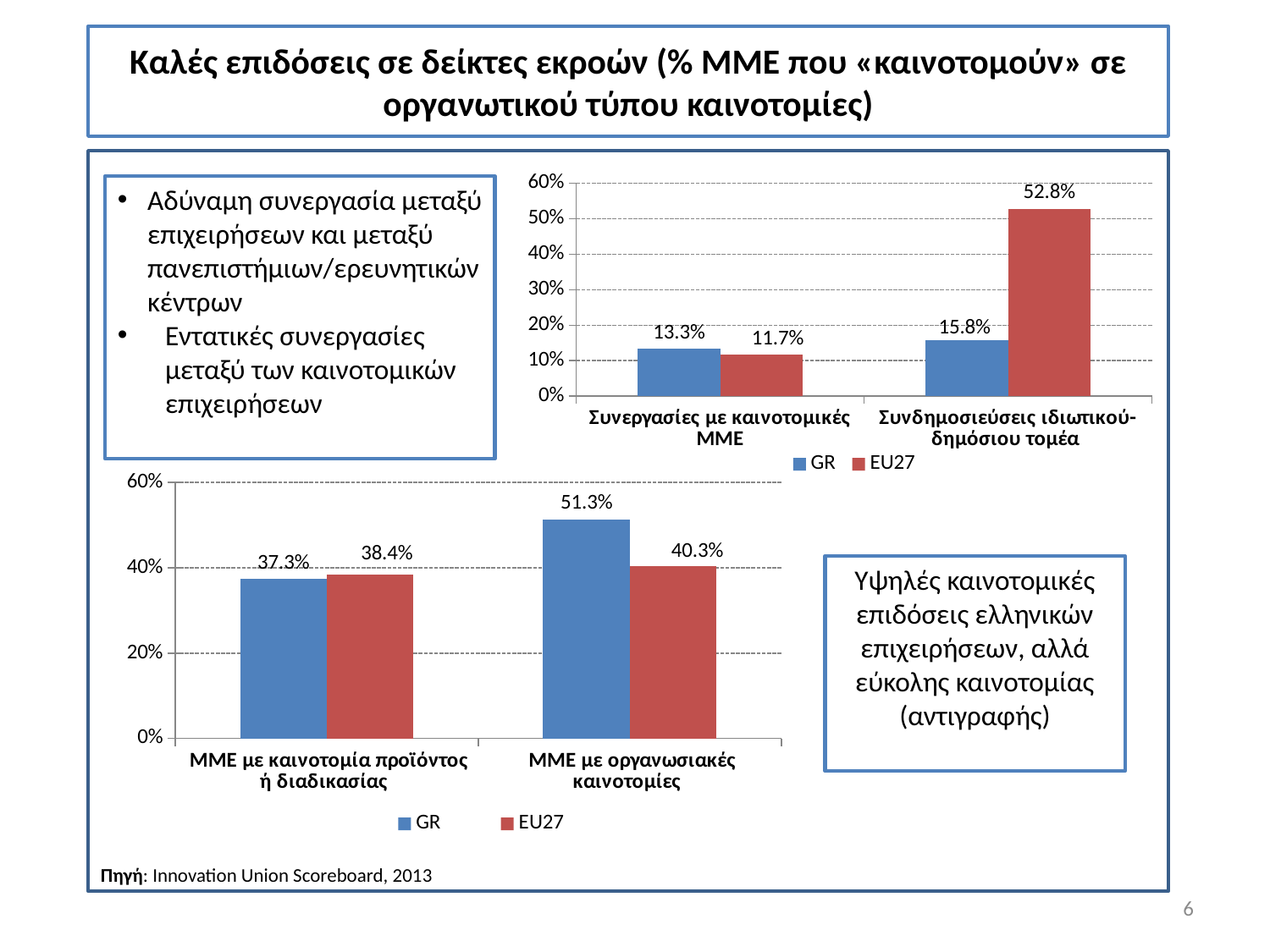
What type of chart is the bottom-left chart? Bar chart In the bottom-left chart, what is the EU27 value for ΜΜΕ με καινοτομία προϊόντος ή διαδικασίας? 38.4% In the top-right chart, what is the GR value for Συνεργασίες με καινοτομικές ΜΜΕ? 13.3% In the bottom-left chart, what is the difference between the GR and EU27 values for ΜΜΕ με οργανωσιακές καινοτομίες? 11.0% In the top-right chart, which is larger for Συνεργασίες με καινοτομικές ΜΜΕ: GR or EU27? GR How many categories are shown on the x axis of the bottom-left chart? 2 In the bottom-left chart, is the GR value for ΜΜΕ με οργανωσιακές καινοτομίες greater or less than 40%? greater How many series does the legend of the top-right chart list? 2 In the top-right chart, what is the difference between the EU27 and GR values for Συνδημοσιεύσεις ιδιωτικού-δημόσιου τομέα? 37.0% In the top-right chart, what is the EU27 value for Συνδημοσιεύσεις ιδιωτικού-δημόσιου τομέα? 52.8% In the top-right chart, which bar has the highest value? EU27, Συνδημοσιεύσεις ιδιωτικού-δημόσιου τομέα In the bottom-left chart, what is the GR value for ΜΜΕ με οργανωσιακές καινοτομίες? 51.3%